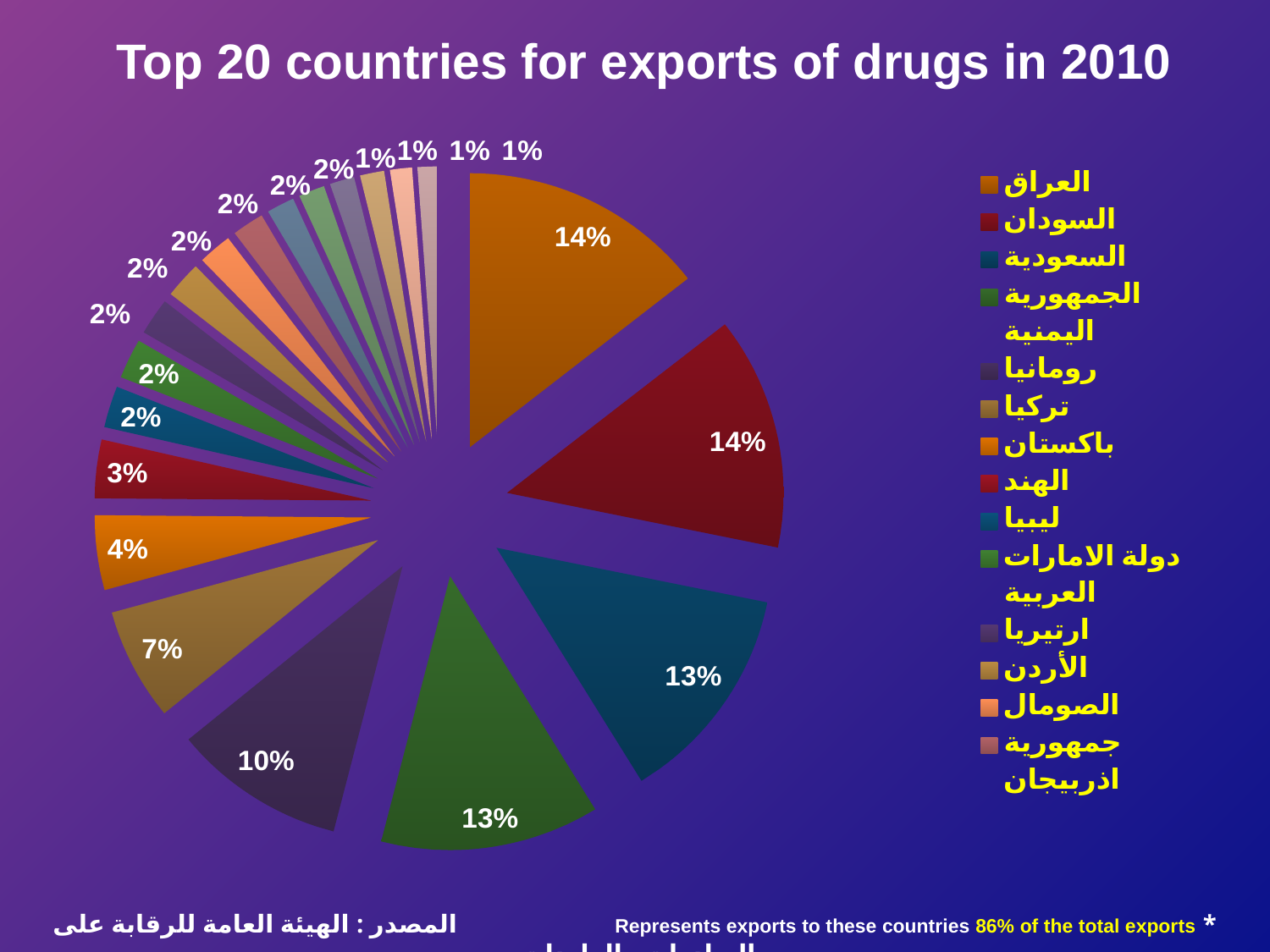
What is the smallest share shown on the pie chart? 1% How many slices does the pie chart have? 20 How many entries does the legend list? 14 What share of exports does رومانيا (the purple slice) represent? 10% What is the title of the chart? Top 20 countries for exports of drugs in 2010 What share of exports does العراق (the first legend entry, orange slice) represent? 14% What share of exports does تركيا (the tan slice) represent? 7% What share of exports does السودان (dark red slice) represent? 14% Which has the larger share, رومانيا or الهند? رومانيا What is the difference in percentage points between the share for رومانيا and the share for تركيا? 3 What kind of chart is shown on the slide? Pie chart What share of exports does باكستان (the orange 4% slice) represent? 4%